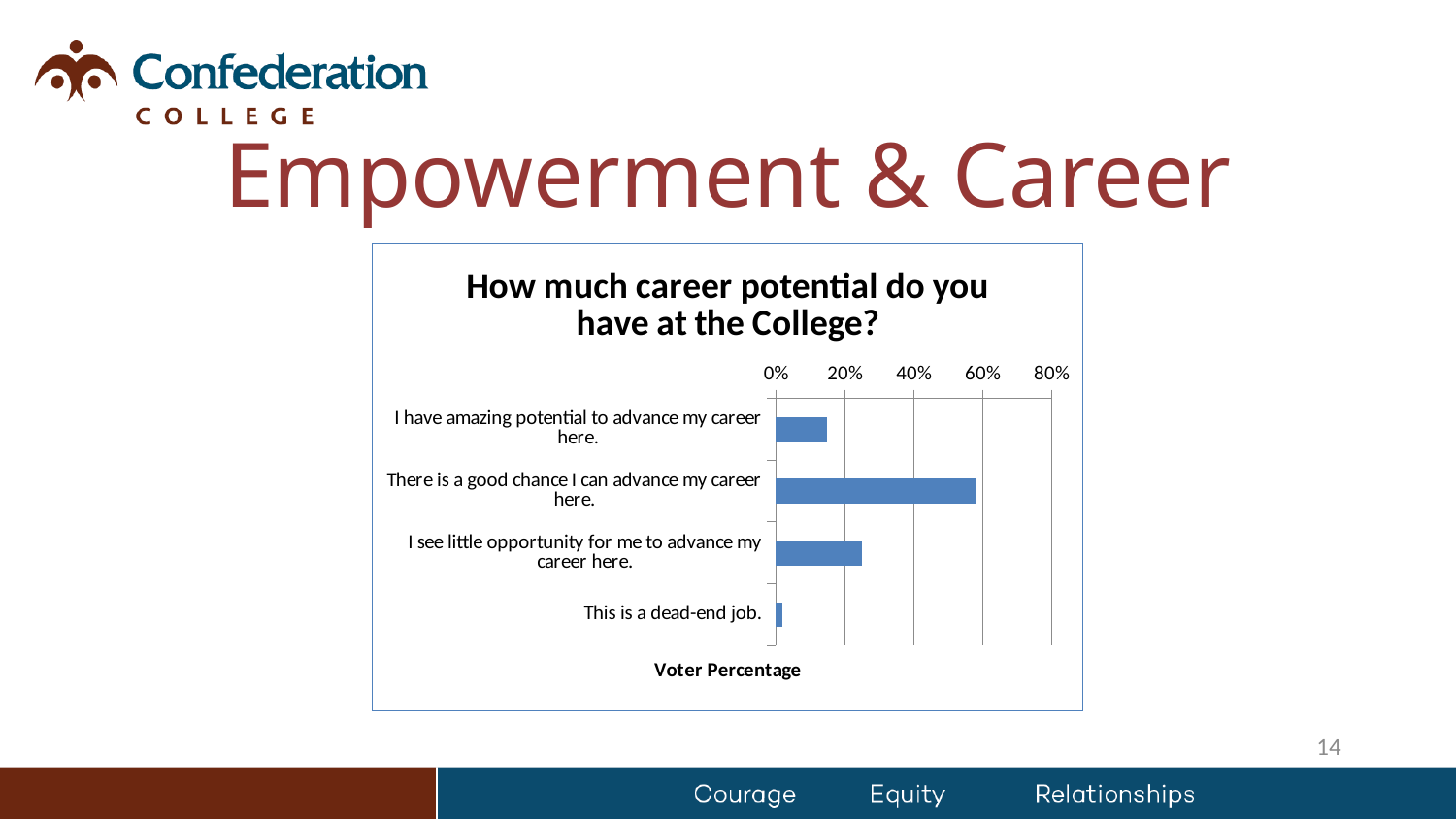
Which response category has the lowest voter percentage? This is a dead-end job. What is the label on the horizontal axis of the chart? Voter Percentage Which response category has the highest voter percentage? There is a good chance I can advance my career here. Is the voter percentage for "There is a good chance I can advance my career here." greater or less than 40%? greater Which has a larger voter percentage: "I have amazing potential to advance my career here." or "I see little opportunity for me to advance my career here."? I see little opportunity for me to advance my career here. Is the voter percentage for "I see little opportunity for me to advance my career here." greater or less than 40%? less How many response categories are plotted in the chart? 4 What kind of chart is shown on the slide? bar chart What is the title of the chart? How much career potential do you have at the College? Is the voter percentage for "I have amazing potential to advance my career here." greater or less than 20%? less Which has a larger voter percentage: "This is a dead-end job." or "I have amazing potential to advance my career here."? I have amazing potential to advance my career here.